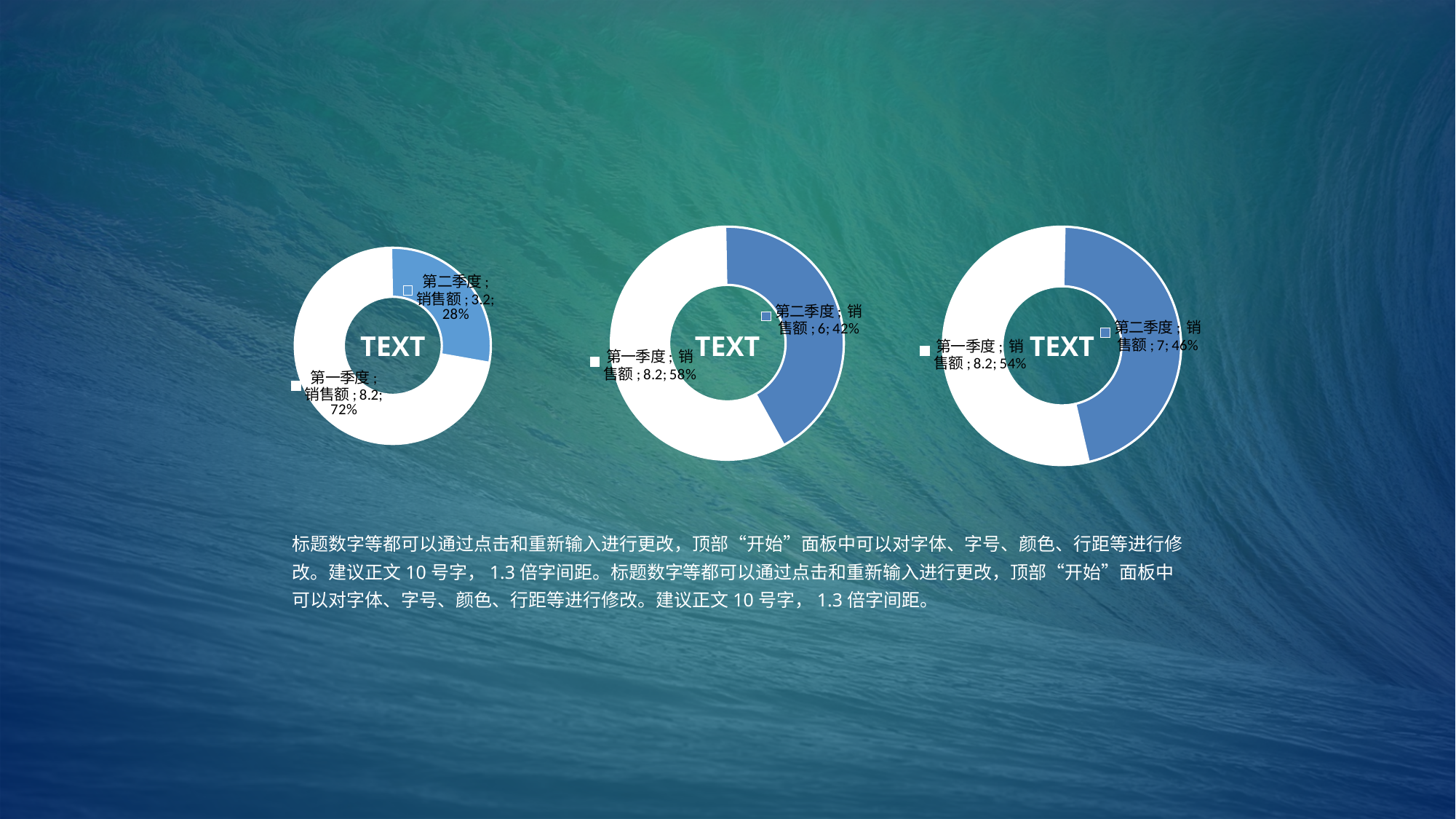
How many categories does the left doughnut chart show? 2 How many doughnut charts are on the slide? 3 In the left doughnut chart, what percentage share does 第二季度 have? 28% In the left doughnut chart, what is the 销售额 value for 第一季度? 8.2 In the right doughnut chart, which category has the larger 销售额, 第一季度 or 第二季度? 第一季度 In the right doughnut chart, what percentage share does 第二季度 have? 46% In the right doughnut chart, what is the 销售额 value for 第二季度? 7 In the left doughnut chart, what is the difference between the 销售额 values of 第一季度 and 第二季度? 5 What kind of chart is the middle chart? Doughnut chart In the middle doughnut chart, what percentage share does 第一季度 have? 58% In the middle doughnut chart, what is the 销售额 value for 第二季度? 6 In the middle doughnut chart, which category has the smallest share? 第二季度